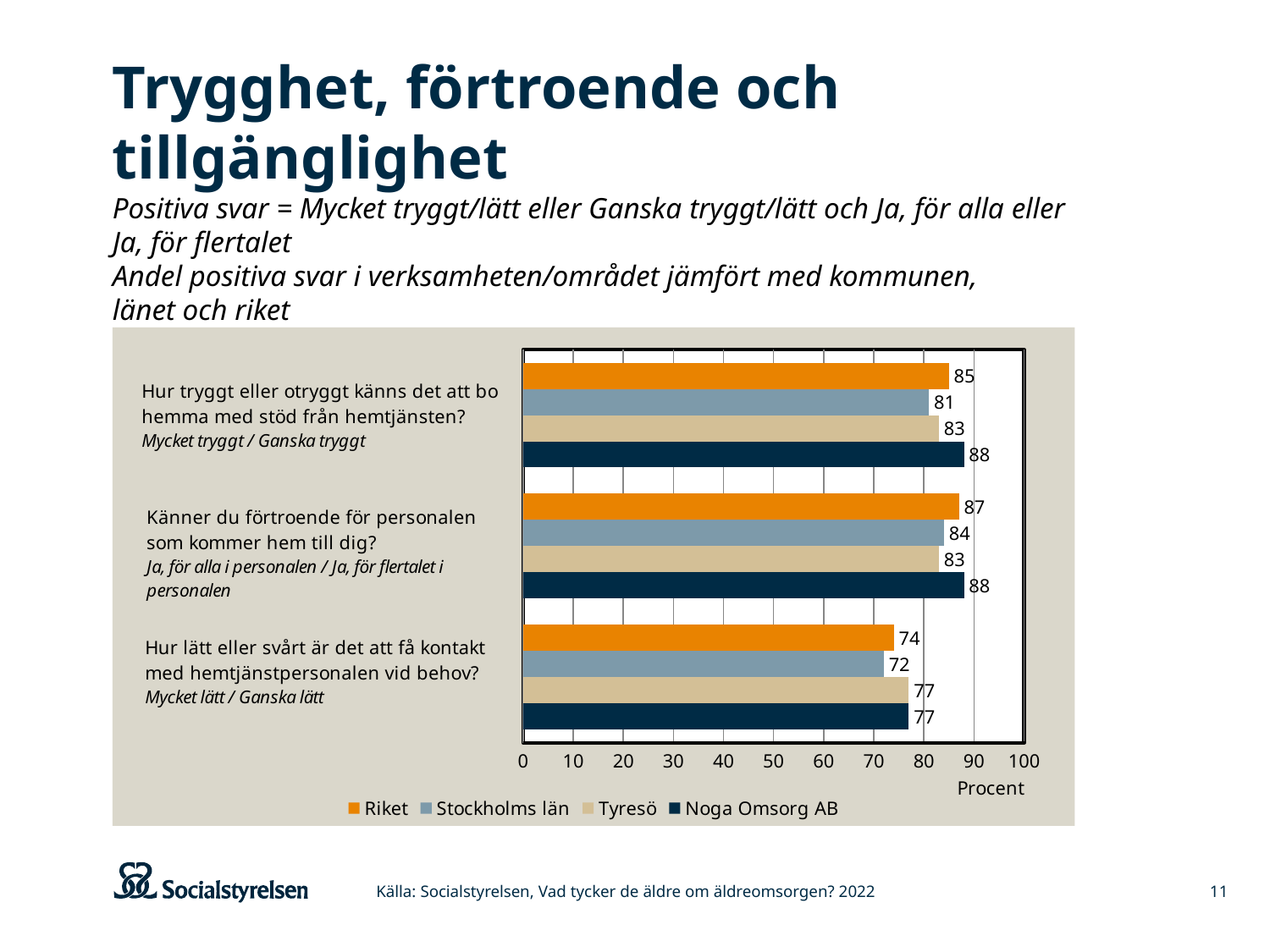
What is the label on the horizontal axis of the chart? Procent What is the difference between the Noga Omsorg AB value and the Stockholms län value for the question "Hur tryggt eller otryggt känns det att bo hemma med stöd från hemtjänsten?"? 7 How many series does the legend list? 4 What kind of chart is shown on the slide? Bar chart Is the Riket value for the question "Hur lätt eller svårt är det att få kontakt med hemtjänstpersonalen vid behov?" greater or less than 80? less Which series has the highest value for the question "Hur tryggt eller otryggt känns det att bo hemma med stöd från hemtjänsten?"? Noga Omsorg AB For the question "Känner du förtroende för personalen som kommer hem till dig?", which is larger: the Riket value or the Tyresö value? Riket What value does Riket have for the question "Känner du förtroende för personalen som kommer hem till dig?"? 87 Which series has the lowest value for the question "Hur lätt eller svårt är det att få kontakt med hemtjänstpersonalen vid behov?"? Stockholms län What value does Stockholms län have for the question "Hur lätt eller svårt är det att få kontakt med hemtjänstpersonalen vid behov?"? 72 What value does Noga Omsorg AB have for the question "Hur tryggt eller otryggt känns det att bo hemma med stöd från hemtjänsten?"? 88 What value does Tyresö have for the question "Hur tryggt eller otryggt känns det att bo hemma med stöd från hemtjänsten?"? 83